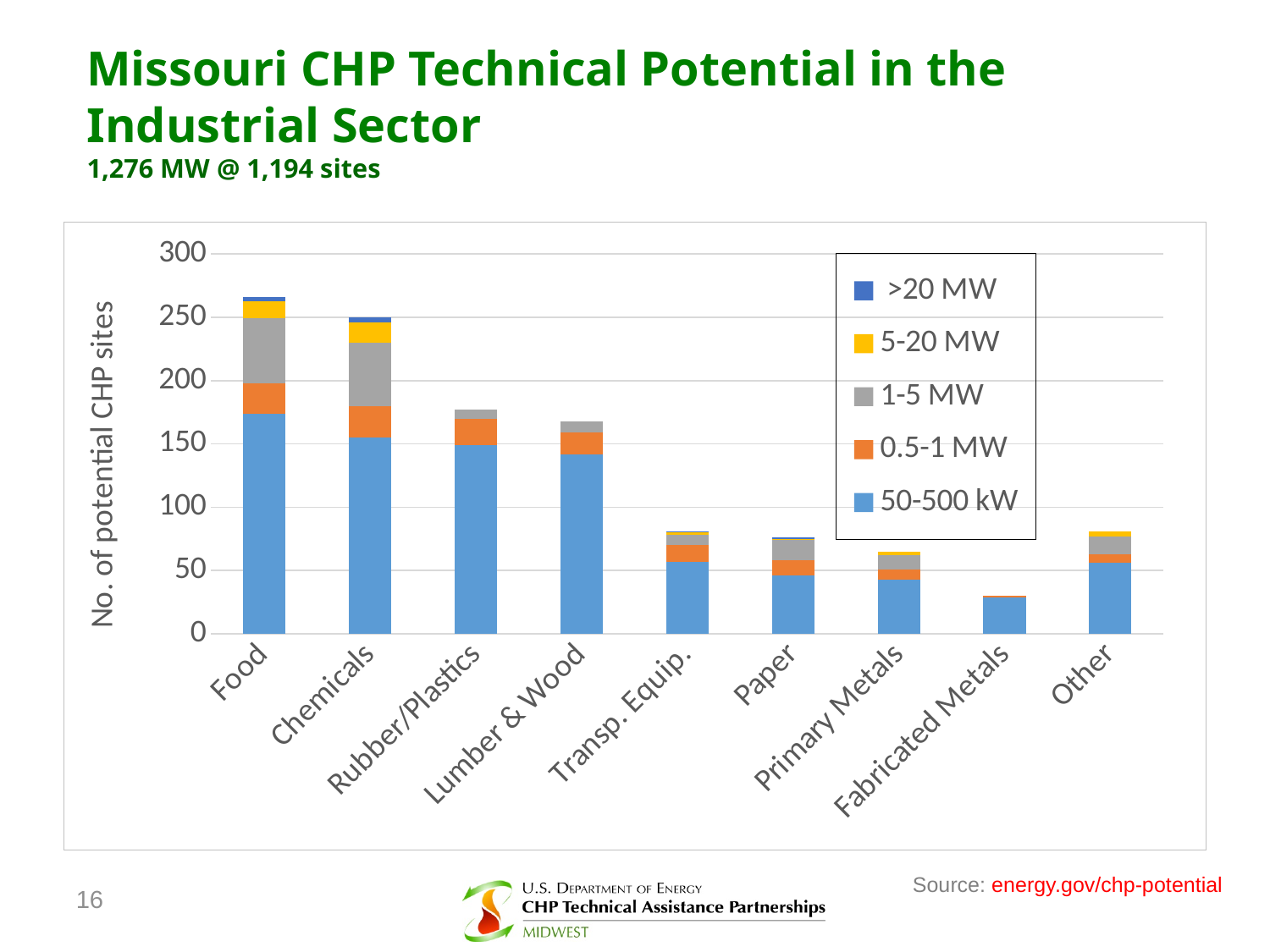
What kind of chart is shown on the slide? Stacked bar chart Is the total value for Food greater or less than 250? greater Which has a larger total number of potential CHP sites, Paper or Fabricated Metals? Paper Which industry category has the lowest total number of potential CHP sites? Fabricated Metals Is the total value for Rubber/Plastics greater or less than 150? greater How many series does the legend list? 5 Is the total value for Transp. Equip. greater or less than 100? less Which has a larger total number of potential CHP sites, Food or Chemicals? Food How many industry categories are shown on the x axis? 9 What is the label on the y axis of the chart? No. of potential CHP sites Which industry category has the highest total number of potential CHP sites? Food